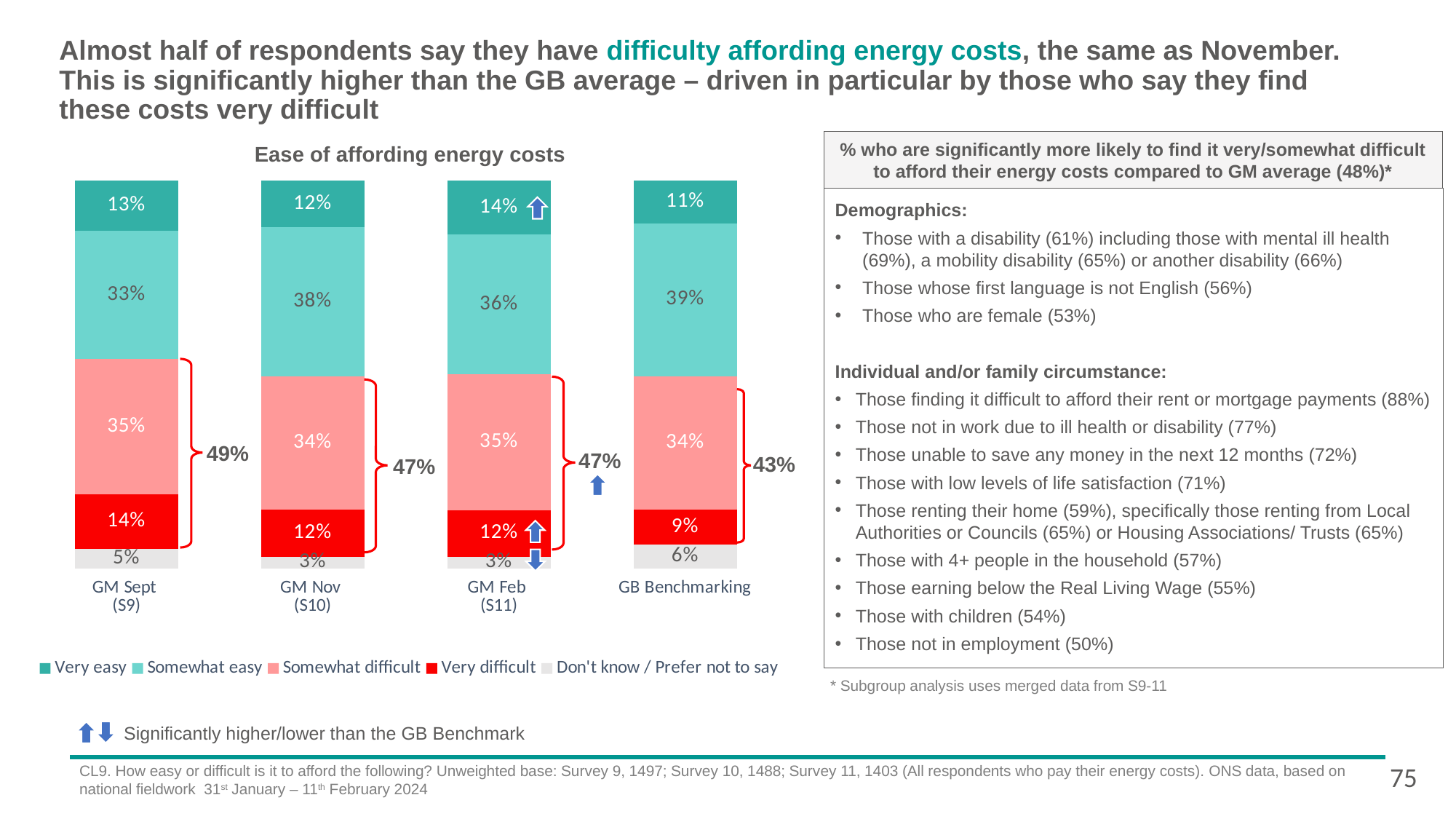
What is the combined 'Somewhat difficult' and 'Very difficult' share for GM Sept (S9)? 49% What percentage of GM Sept (S9) respondents said it was very difficult to afford energy costs? 14% Which category has the lowest 'Very difficult' value? GB Benchmarking What type of chart is used to show ease of affording energy costs? Stacked bar chart What is the 'Somewhat easy' value for GB Benchmarking? 39% How many percentage points higher is the 'Somewhat easy' value for GM Nov (S10) than for GM Sept (S9)? 5 percentage points What is the 'Very easy' value for GM Feb (S11)? 14% Which has the larger 'Very easy' value, GM Sept (S9) or GB Benchmarking? GM Sept (S9) What is the 'Don't know / Prefer not to say' value for GB Benchmarking? 6% Which category has the highest 'Somewhat easy' value? GB Benchmarking How many series does the legend list? 5 How many categories (bars) are shown in the chart? 4